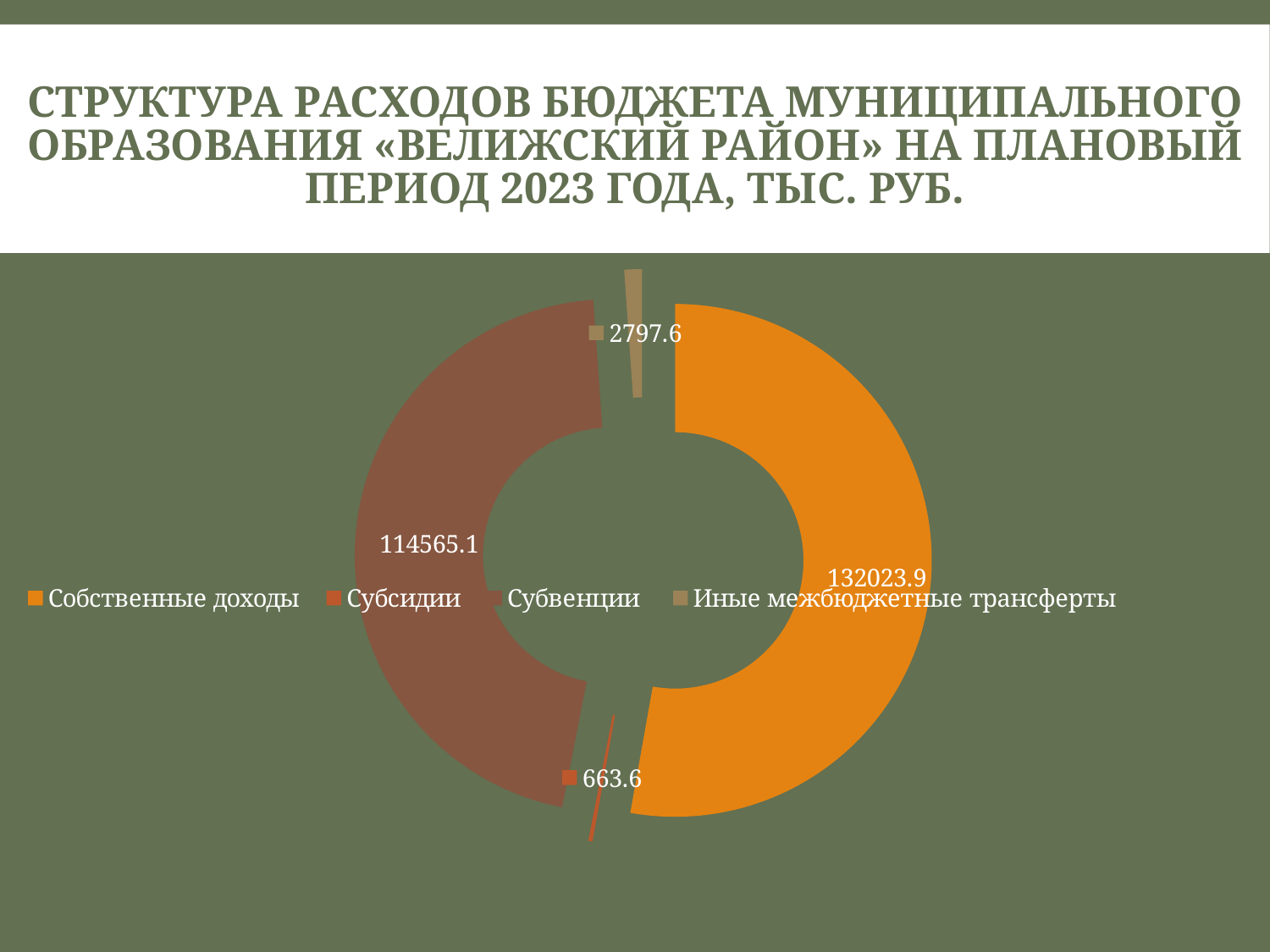
What type of chart is shown on the slide? Doughnut (pie) chart What is the value for Субвенции? 114565.1 How many categories does the chart show? 4 What is the value for Собственные доходы? 132023.9 How many entries does the legend list? 4 Which is larger, Иные межбюджетные трансферты or Субсидии? Иные межбюджетные трансферты Which category has the smallest value? Субсидии What is the value for Иные межбюджетные трансферты? 2797.6 Which category has the largest value? Собственные доходы What is the difference between Собственные доходы and Субвенции? 17458.8 What is the value for Субсидии? 663.6 What colour is the Собственные доходы segment? Orange